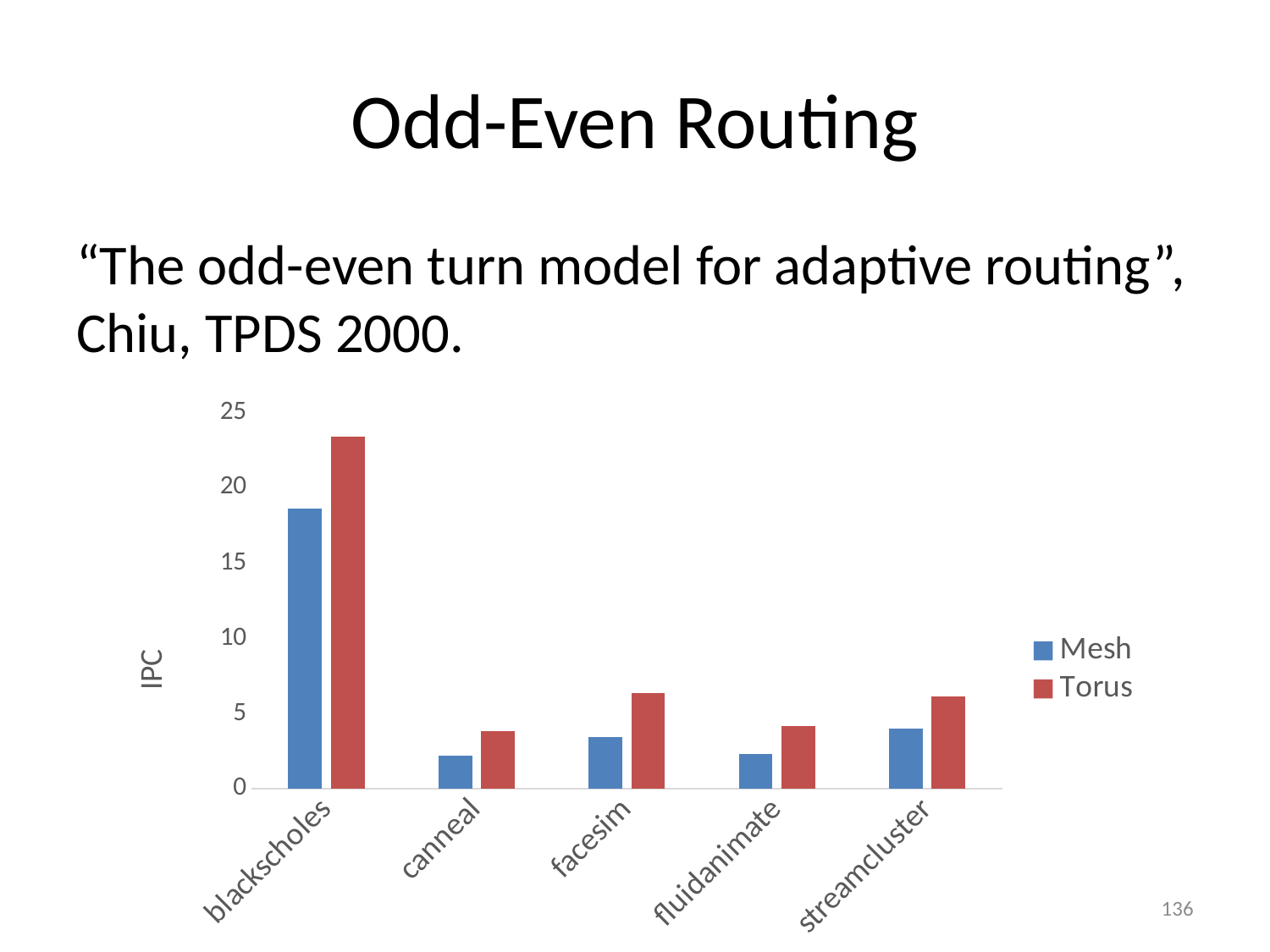
What is the label on the y axis? IPC For blackscholes, which series has the larger IPC, Mesh or Torus? Torus Which category has the highest Mesh IPC? blackscholes Which category has the highest Torus IPC? blackscholes For facesim, which series has the larger IPC, Mesh or Torus? Torus Is the Mesh IPC for canneal greater or less than 5? less What kind of chart is shown on the slide? bar chart Is the Torus IPC for blackscholes greater or less than 20? greater How many benchmark categories are shown on the x axis? 5 Which colour represents the Torus series in the legend? red How many series does the legend list? 2 Which category has the lowest Torus IPC? canneal